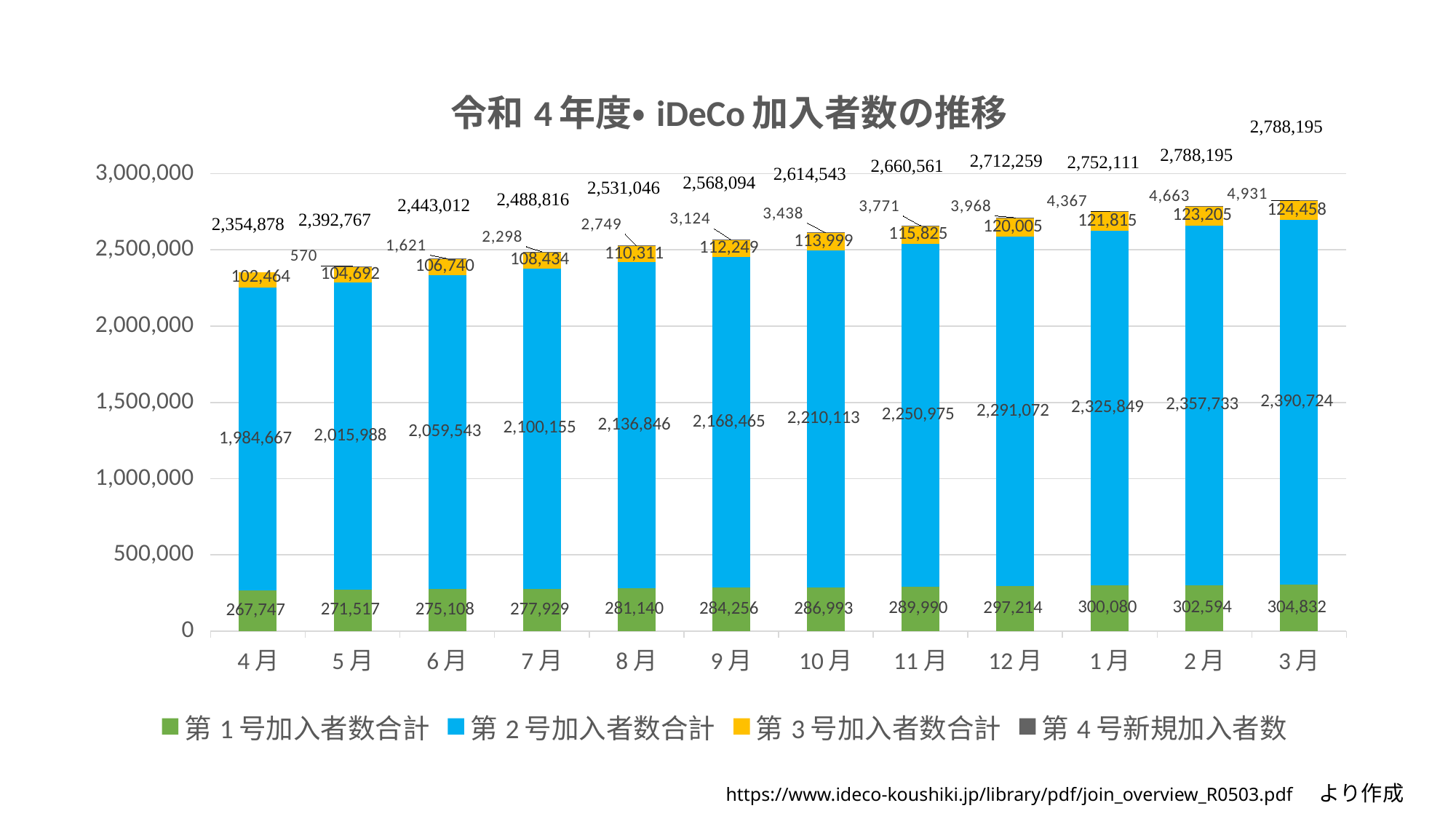
What is the value of 第３号加入者数合計 for ９月? 112,249 How many series does the legend list? 4 How many months are shown on the x axis? 12 What kind of chart is shown on the slide? Stacked bar chart What is the value of 第４号新規加入者数 for １２月? 3,968 Which month has the lowest value for 第１号加入者数合計? ４月 Which month has the larger value for 第３号加入者数合計, ７月 or ８月? ８月 What is the value of 第１号加入者数合計 for ３月? 304,832 What is the total of the stacked bar for １０月? 2,614,543 What is the value of 第２号加入者数合計 for ４月? 1,984,667 Which month has the highest value for 第２号加入者数合計? ３月 What is the difference between the 第１号加入者数合計 values for ３月 and ４月? 37,085